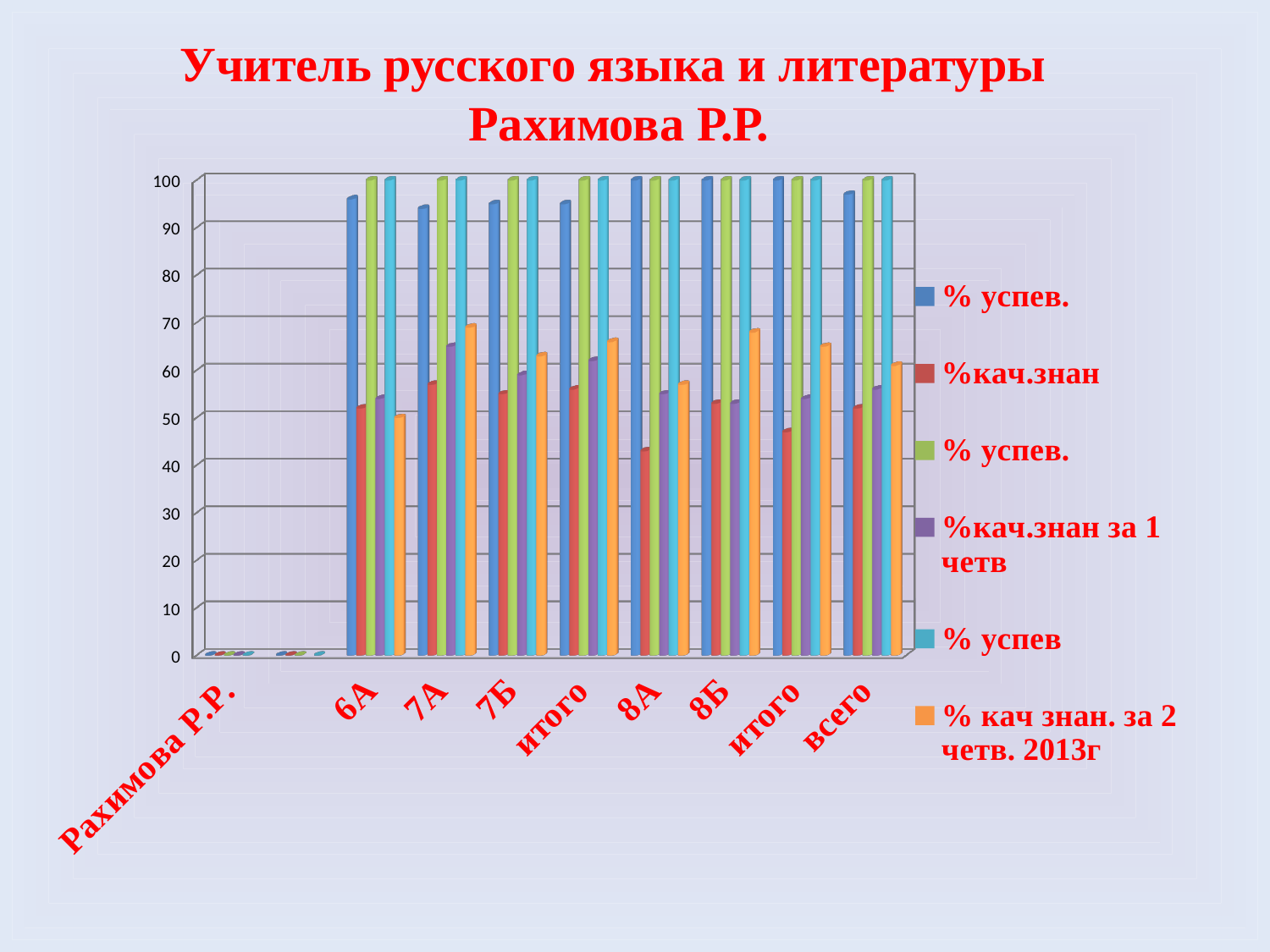
Which is larger for the '% кач знан. за 2 четв. 2013г' series: the value for 6А or the value for 7А? 7А Is the value of the '% успев.' (first, blue) series for 6А greater or less than 90? greater Is the value of the '%кач.знан за 1 четв' series for 7А greater or less than 60? greater Is the value of the '% кач знан. за 2 четв. 2013г' series for 7А greater or less than 60? greater Which category has the lowest value in the '% кач знан. за 2 четв. 2013г' (orange) series? 6А How many series does the legend list? 6 Which category has the lowest value in the '%кач.знан' (red) series? 8А What kind of chart is shown on the slide? bar chart Which legend entry is shown in orange? % кач знан. за 2 четв. 2013г What is the title of the slide above the chart? Учитель русского языка и литературы Рахимова Р.Р.